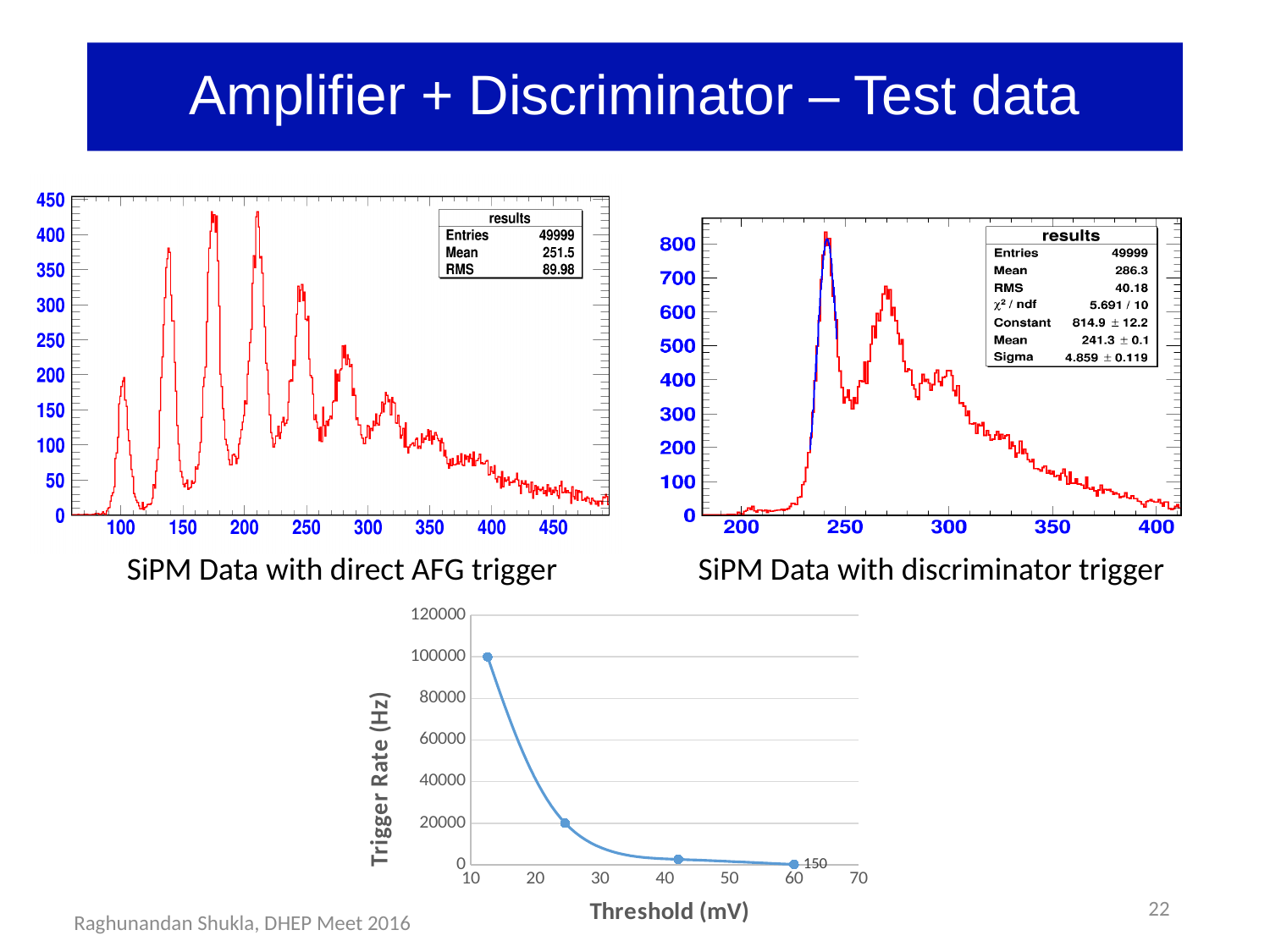
In the bottom chart (Trigger Rate vs Threshold), is the trigger rate at a threshold of about 42 mV greater or less than 20000? less In the bottom chart (Trigger Rate vs Threshold), does the trigger rate rise or fall as the threshold increases? fall In the chart titled 'SiPM Data with direct AFG trigger', what is the Mean shown in the results box? 251.5 In the bottom chart, what is the label of the y axis? Trigger Rate (Hz) In the chart titled 'SiPM Data with discriminator trigger', what is the number of Entries shown in the results box? 49999 In the bottom chart (Trigger Rate vs Threshold), what is the trigger rate at a threshold of 60 mV? 150 In the bottom chart (Trigger Rate vs Threshold), is the trigger rate at the leftmost point greater or less than 80000? greater What kind of chart is the bottom chart (Trigger Rate vs Threshold)? line chart Which chart has the larger RMS in its results box, 'SiPM Data with direct AFG trigger' or 'SiPM Data with discriminator trigger'? SiPM Data with direct AFG trigger In the bottom chart (Trigger Rate vs Threshold), how many data points are plotted? 4 In the chart titled 'SiPM Data with discriminator trigger', what is the RMS shown in the results box? 40.18 In the chart titled 'SiPM Data with direct AFG trigger', what is the RMS shown in the results box? 89.98